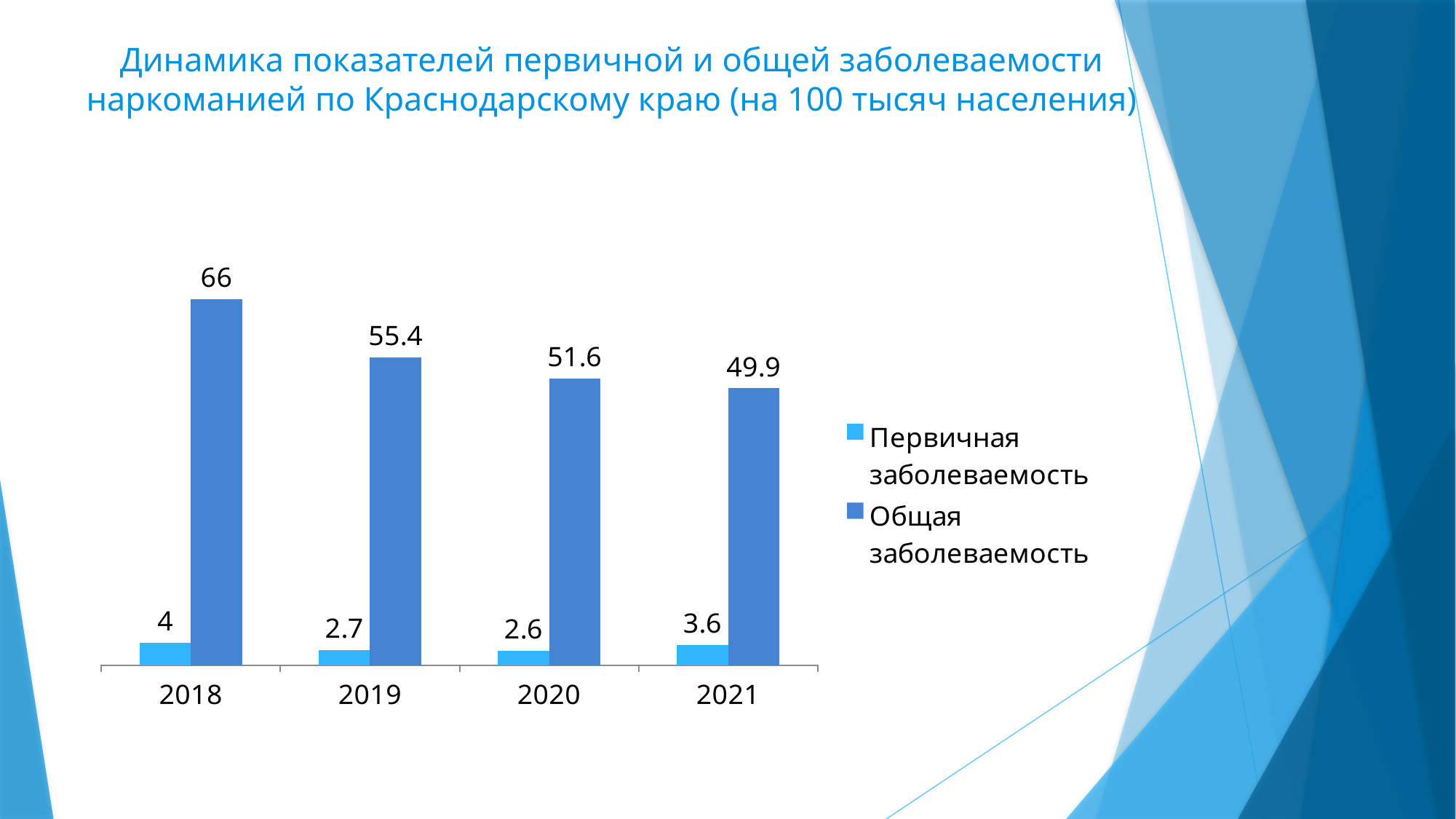
What is the value of Общая заболеваемость for 2018? 66 What is the value of Первичная заболеваемость for 2019? 2.7 Which year has the lowest value for Первичная заболеваемость? 2020 How many years are shown on the x axis? 4 What is the value of Общая заболеваемость for 2021? 49.9 What is the difference between Общая заболеваемость in 2018 and in 2021? 16.1 Which year has the highest value for Общая заболеваемость? 2018 Does Общая заболеваемость rise or fall from 2018 to 2021? Fall What kind of chart is shown on the slide? Bar chart What is the value of Первичная заболеваемость for 2021? 3.6 How many series does the legend list? 2 Which is larger: Первичная заболеваемость in 2018 or in 2021? 2018